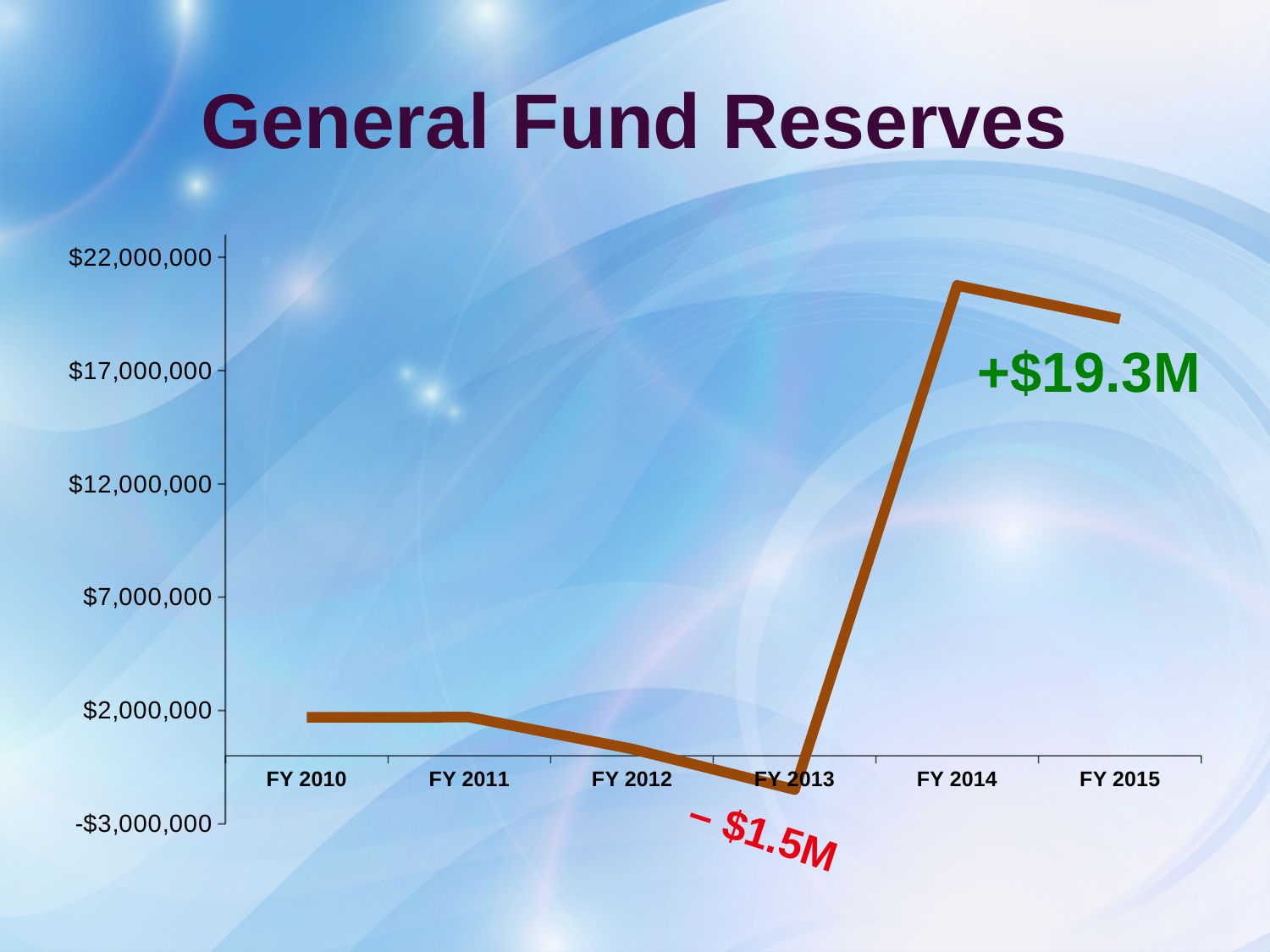
Do the values rise or fall from FY 2011 to FY 2013? fall Is the value for FY 2010 greater or less than $7,000,000? less Is the value for FY 2014 greater or less than $17,000,000? greater Which fiscal year has the lowest General Fund Reserves value? FY 2013 What is the title of the chart? General Fund Reserves What kind of chart is shown on the slide? line chart Which fiscal year has the highest General Fund Reserves value? FY 2014 Is the value for FY 2013 greater or less than $2,000,000? less How many fiscal years are plotted on the x axis? 6 What annotation is printed in red near the FY 2013 point? − $1.5M Which is larger, the value for FY 2015 or the value for FY 2010? FY 2015 Which is larger, the value for FY 2014 or the value for FY 2012? FY 2014